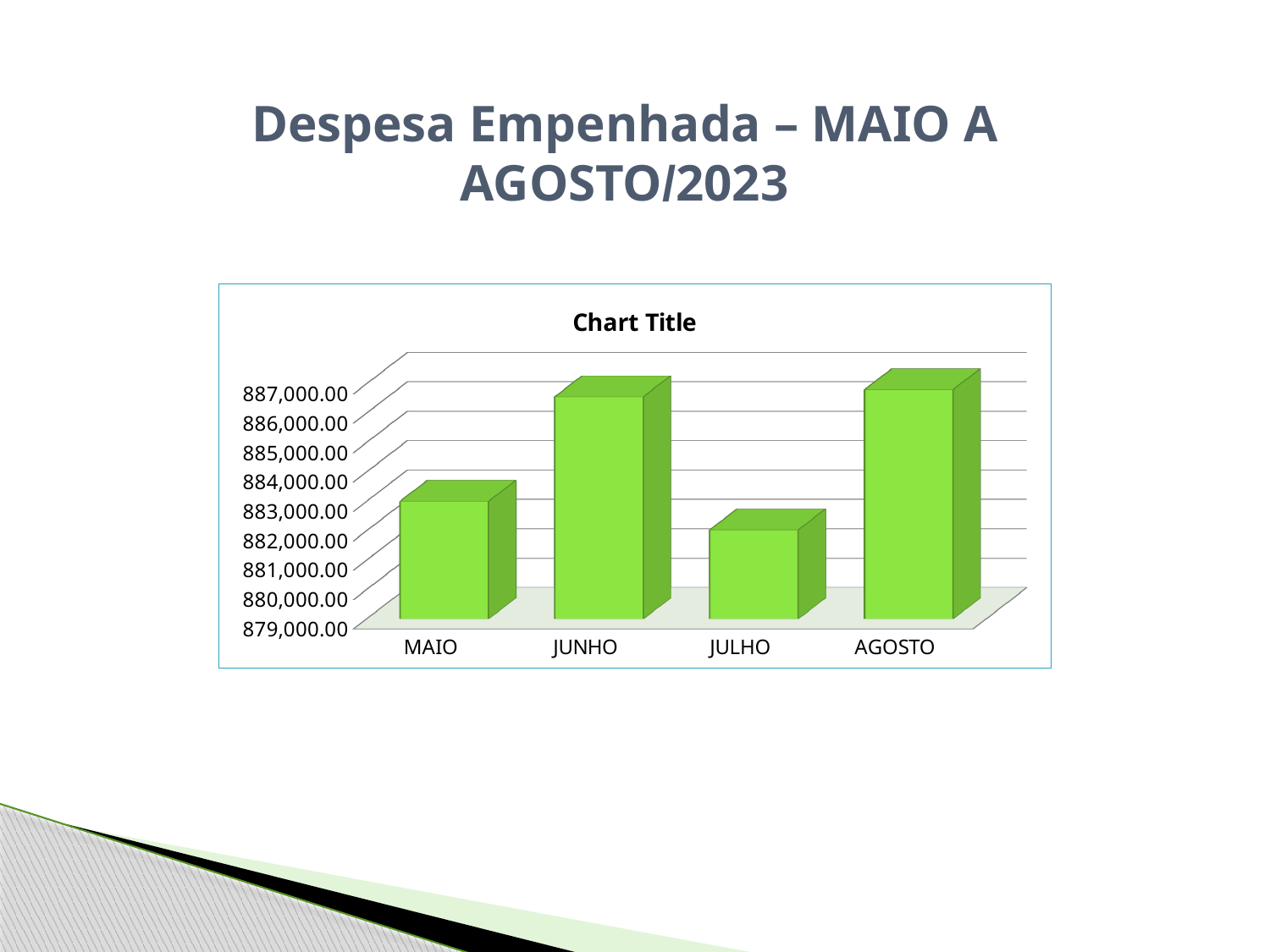
Is the value for JULHO greater or less than 884,000.00? less Is the value for MAIO greater or less than 881,000.00? greater Which is larger, the value for JUNHO or the value for JULHO? JUNHO What is the title printed inside the chart area? Chart Title Which is larger, the value for AGOSTO or the value for MAIO? AGOSTO How many categories are shown on the x axis of the chart? 4 Does the value rise or fall from JUNHO to JULHO? fall What kind of chart is shown on the slide? bar chart Which category has the lowest value in the chart? JULHO Is the value for AGOSTO greater or less than 885,000.00? greater Which is larger, the value for MAIO or the value for JULHO? MAIO